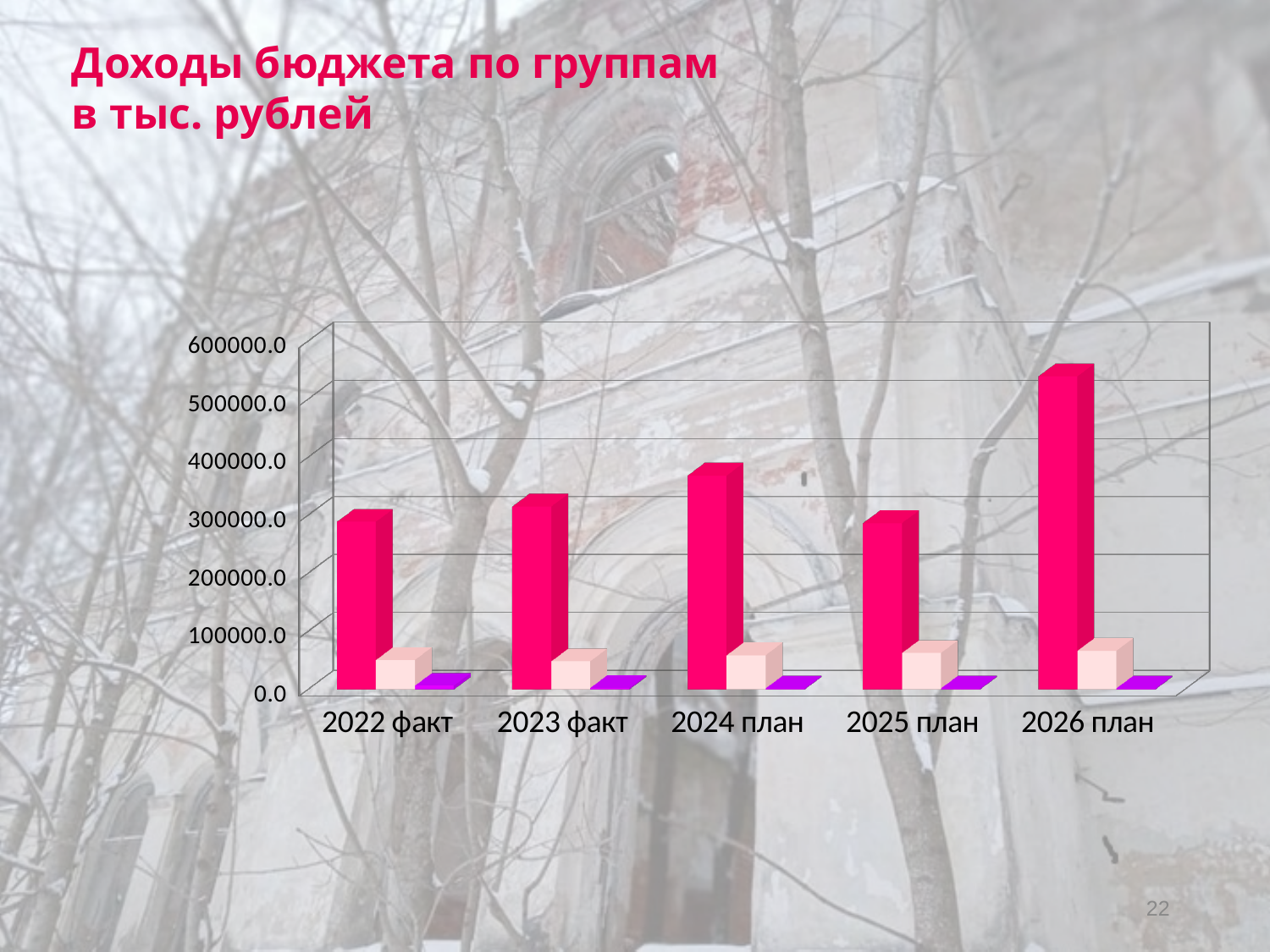
Which category has the tallest magenta bar? 2026 план What is the title of the chart? Доходы бюджета по группам в тыс. рублей What kind of chart is shown on the slide? bar chart Is the magenta bar for 2023 факт greater or less than 400000.0? less Which magenta bar is taller, 2024 план or 2023 факт? 2024 план Is the magenta bar for 2024 план greater or less than 400000.0? less Is the pale pink bar for 2026 план greater or less than 100000.0? less How many bars are plotted for each category? 3 How many categories are shown on the x axis? 5 Which magenta bar is taller, 2026 план or 2025 план? 2026 план